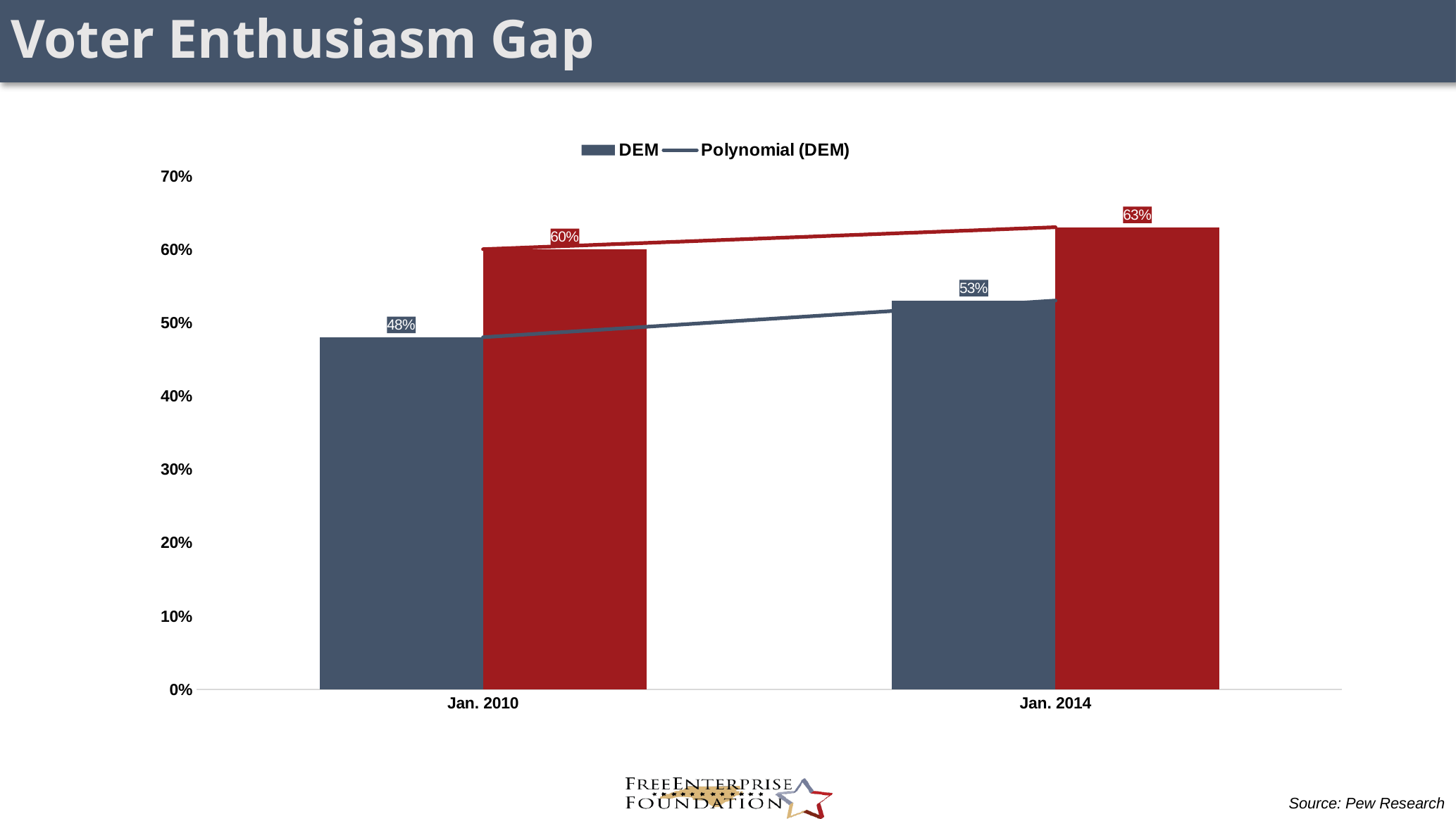
What kind of chart is shown on the slide? bar chart What is the DEM value for Jan. 2014? 53% What value is shown on the red bar for Jan. 2010? 60% What is the difference between the red bar and the DEM bar for Jan. 2014? 10% By how much did the DEM value change from Jan. 2010 to Jan. 2014? 5% Which category has the higher DEM value, Jan. 2010 or Jan. 2014? Jan. 2014 What is the difference between the red bar and the DEM bar for Jan. 2010? 12% What is the DEM value for Jan. 2010? 48% How many categories are shown on the x axis? 2 Does the DEM value rise or fall from Jan. 2010 to Jan. 2014? rise What value is shown on the red bar for Jan. 2014? 63% What is the title of the slide containing the chart? Voter Enthusiasm Gap